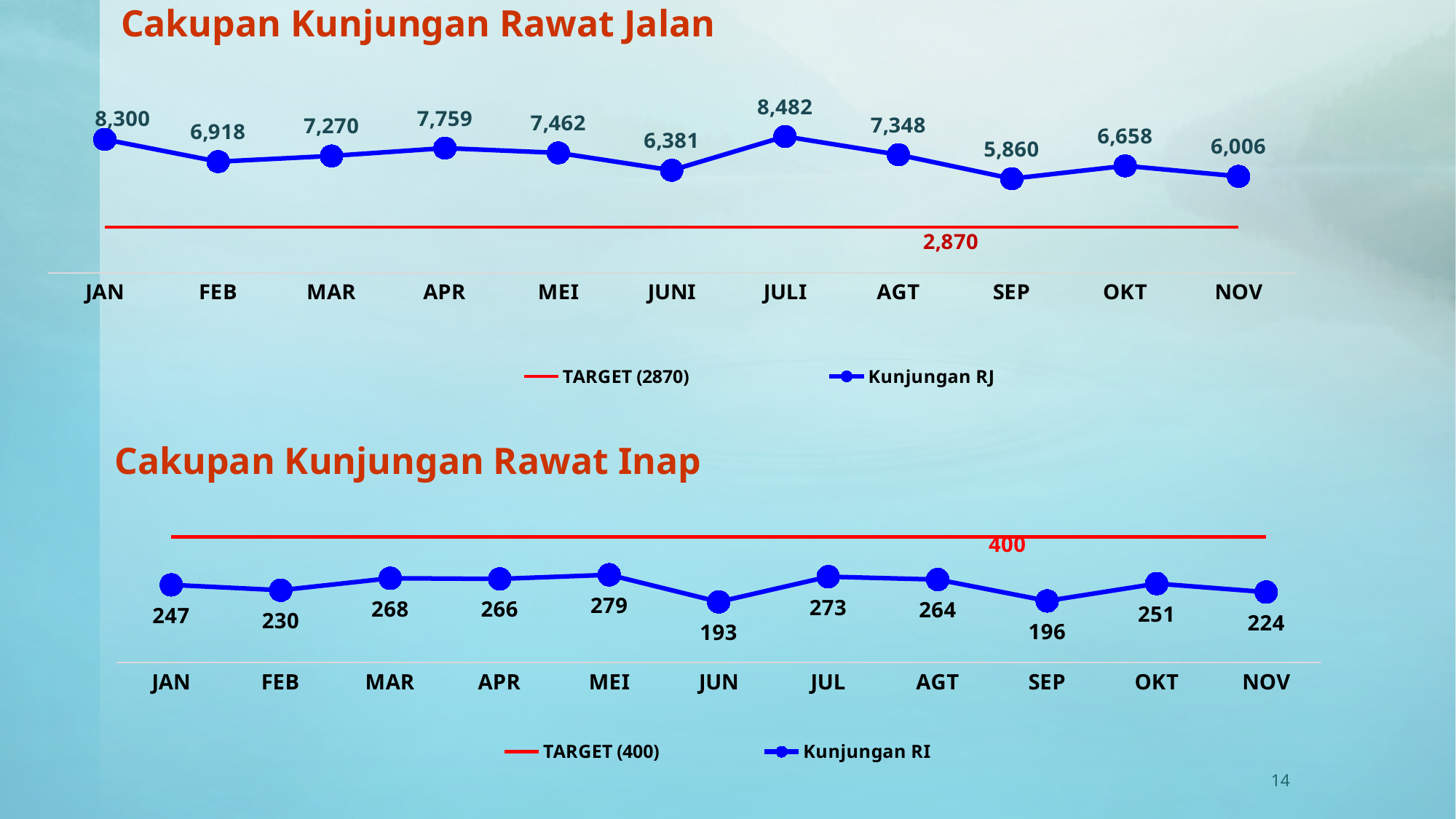
In the 'Cakupan Kunjungan Rawat Jalan' chart, how many months are plotted on the x axis? 11 In the 'Cakupan Kunjungan Rawat Inap' chart, what is the Kunjungan RI value for MEI? 279 In the 'Cakupan Kunjungan Rawat Jalan' chart, what is the Kunjungan RJ value for JULI? 8,482 In the 'Cakupan Kunjungan Rawat Jalan' chart, which month has the highest Kunjungan RJ value? JULI In the 'Cakupan Kunjungan Rawat Inap' chart, how many series does the legend list? 2 In the 'Cakupan Kunjungan Rawat Inap' chart, which month has the lowest Kunjungan RI value? JUN In the 'Cakupan Kunjungan Rawat Inap' chart, is the Kunjungan RI value for MAR or APR larger? MAR In the 'Cakupan Kunjungan Rawat Inap' chart, what is the difference between the MEI and JUN Kunjungan RI values? 86 What kind of chart is 'Cakupan Kunjungan Rawat Inap'? Line chart In the 'Cakupan Kunjungan Rawat Jalan' chart, what is the difference between the JAN and FEB Kunjungan RJ values? 1,382 In the 'Cakupan Kunjungan Rawat Jalan' chart, which month has the lowest Kunjungan RJ value? SEP In the 'Cakupan Kunjungan Rawat Jalan' chart, what is the target value shown by the red line? 2,870